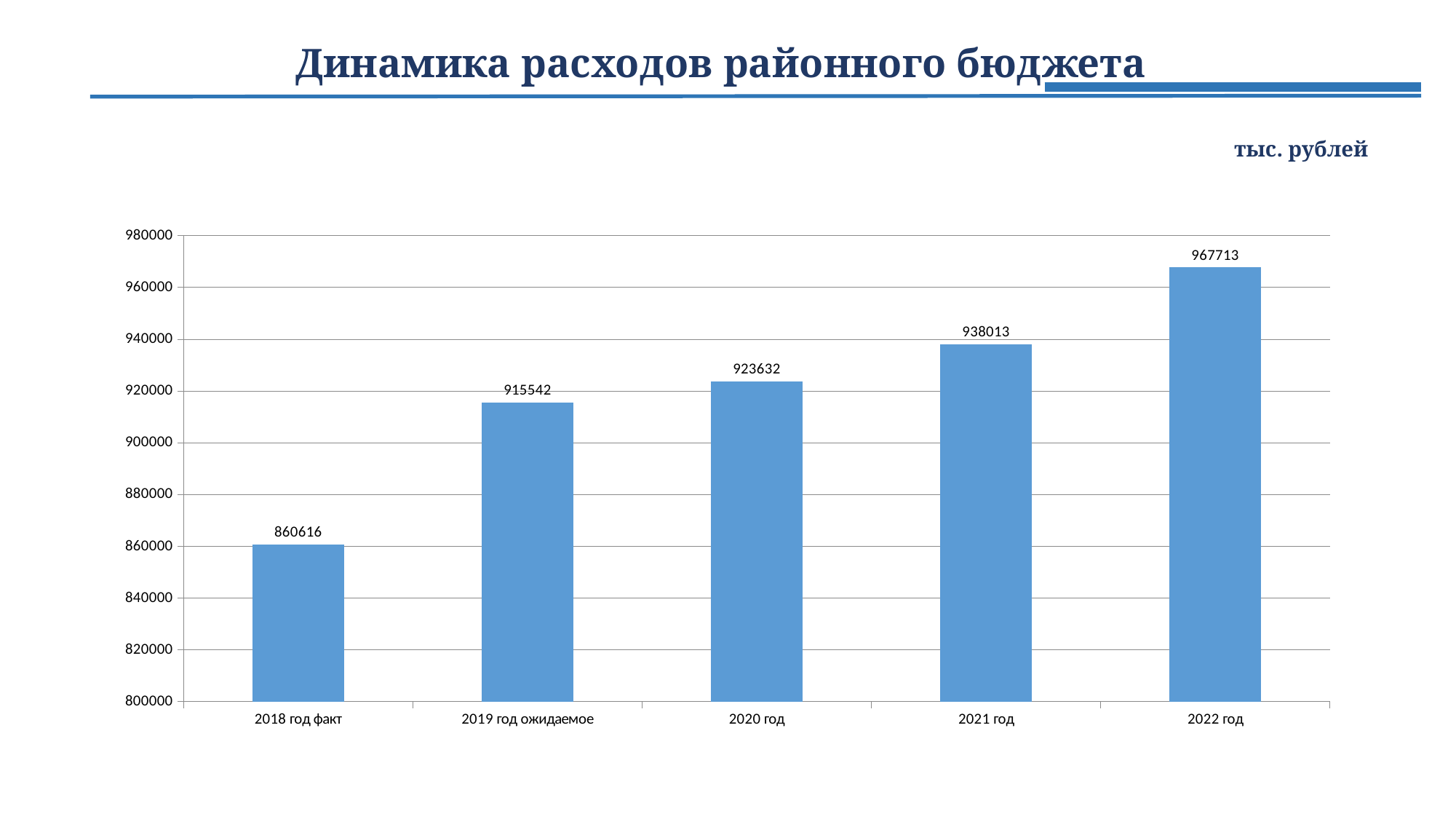
What kind of chart is shown on the slide? bar chart What is the value for "2020 год"? 923632 Which is larger, the value for "2019 год ожидаемое" or the value for "2021 год"? 2021 год Which category has the lowest value? 2018 год факт Which category has the highest value? 2022 год What is the value for "2022 год"? 967713 Is the value for "2019 год ожидаемое" greater or less than 900000? greater How many categories are shown on the x axis? 5 What is the difference between the values for "2022 год" and "2018 год факт"? 107097 What is the difference between the values for "2021 год" and "2020 год"? 14381 Do the values rise or fall from "2018 год факт" to "2022 год"? rise What is the value for "2018 год факт"? 860616